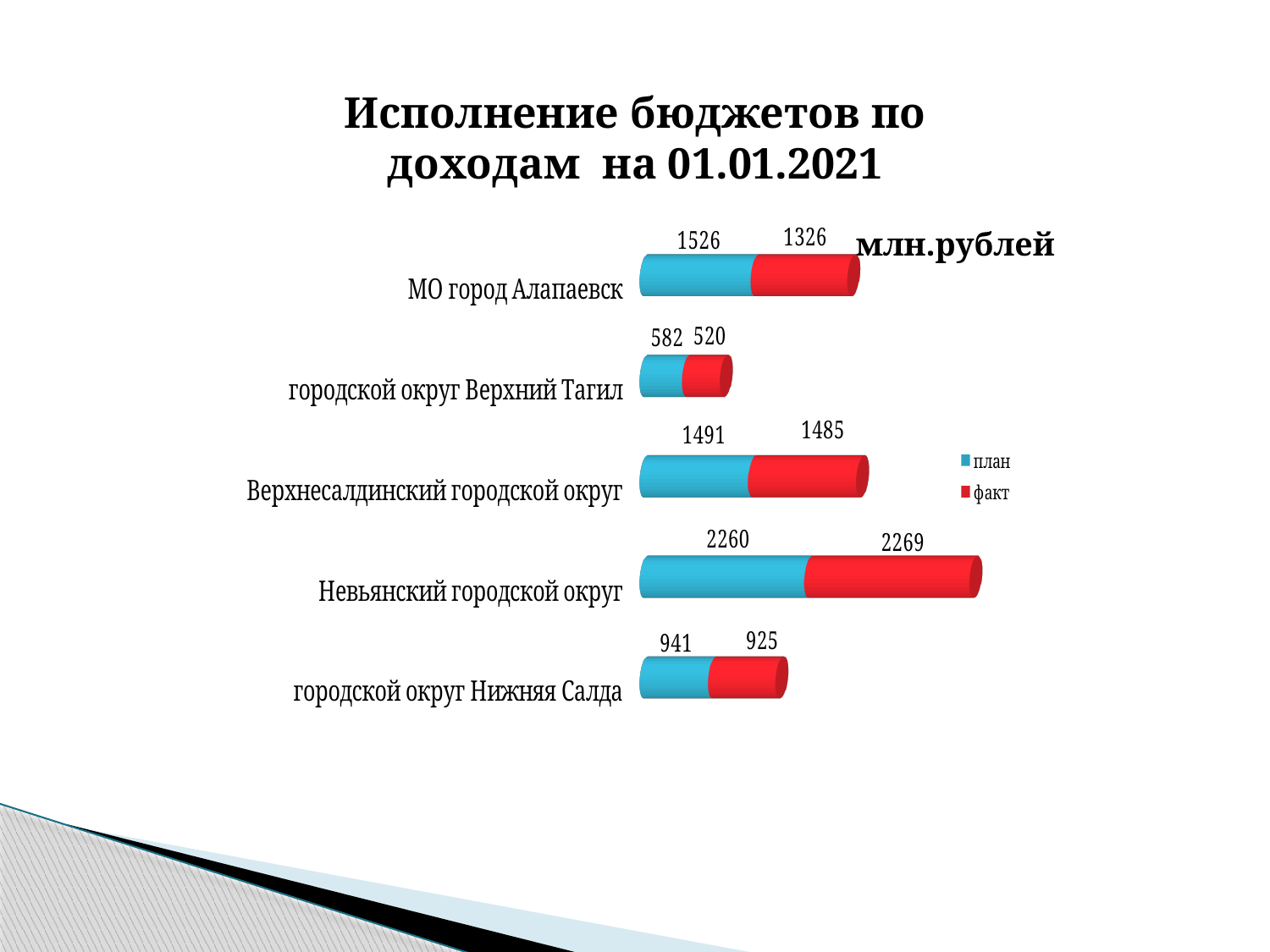
What kind of chart is shown on the slide? bar chart How many categories are shown in the chart? 5 What is the факт value for городской округ Верхний Тагил? 520 How many series does the legend list? 2 Which category has the highest факт value? Невьянский городской округ What is the difference between the план and факт values for МО город Алапаевск? 200 Which is larger for городской округ Нижняя Салда, the план value or the факт value? план What is the total of the stacked bar for Верхнесалдинский городской округ? 2976 Which category has the lowest план value? городской округ Верхний Тагил What is the план value for Невьянский городской округ? 2260 What is the факт value for МО город Алапаевск? 1326 What unit is indicated for the values in the chart? млн.рублей